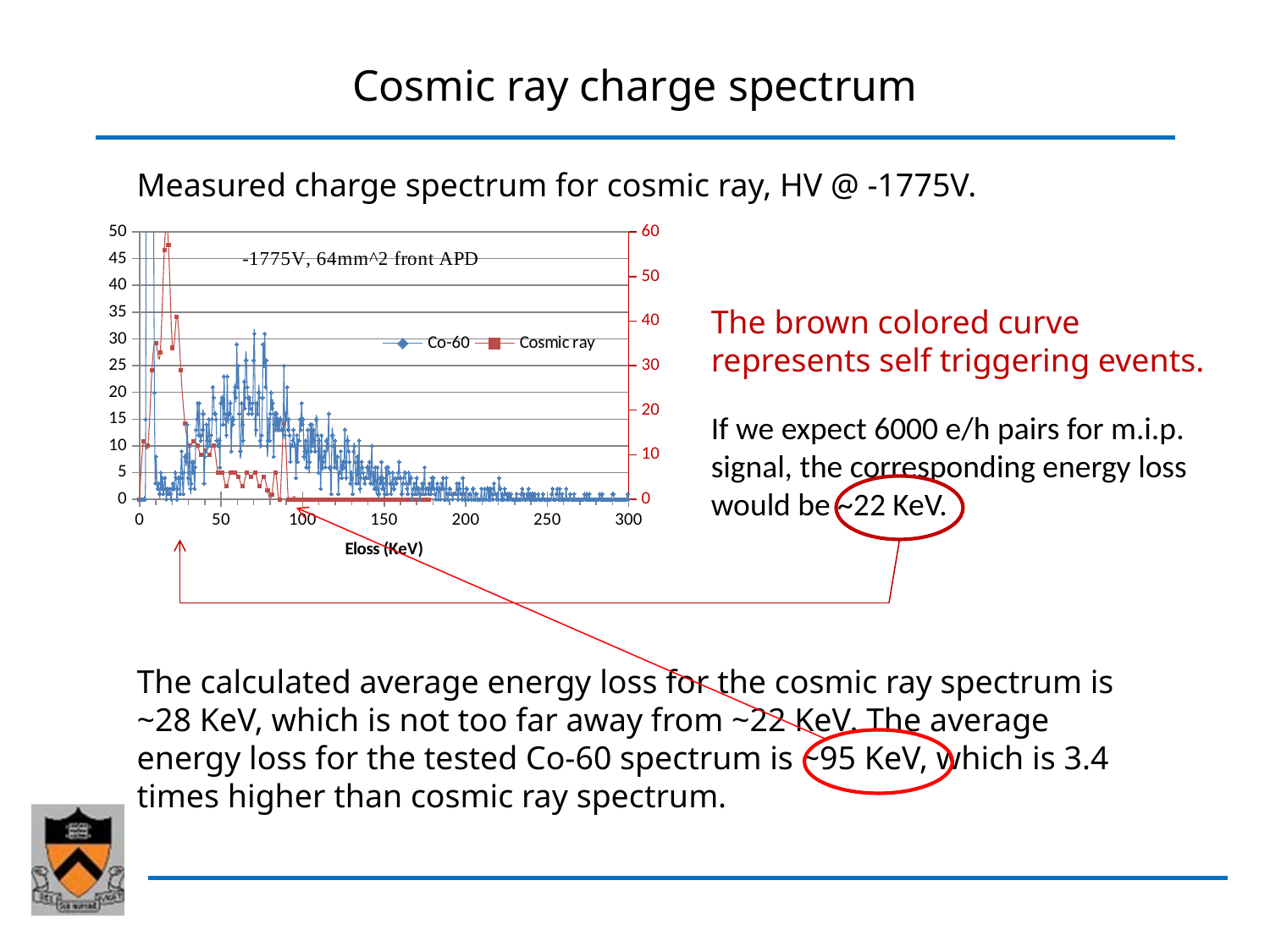
What is the title of the chart's x axis? Eloss (KeV) Are the Co-60 values beyond 250 KeV greater or less than 10 on the left axis? less What are the two series named in the chart legend? Co-60 and Cosmic ray Is the peak value of the Cosmic ray series greater or less than 40? greater Does the Co-60 series rise or fall as Eloss increases from 100 KeV to 300 KeV? fall What kind of chart is shown on the slide? line chart Is the peak value of the Co-60 series greater or less than 20 on the left axis? greater How many series does the chart legend list? 2